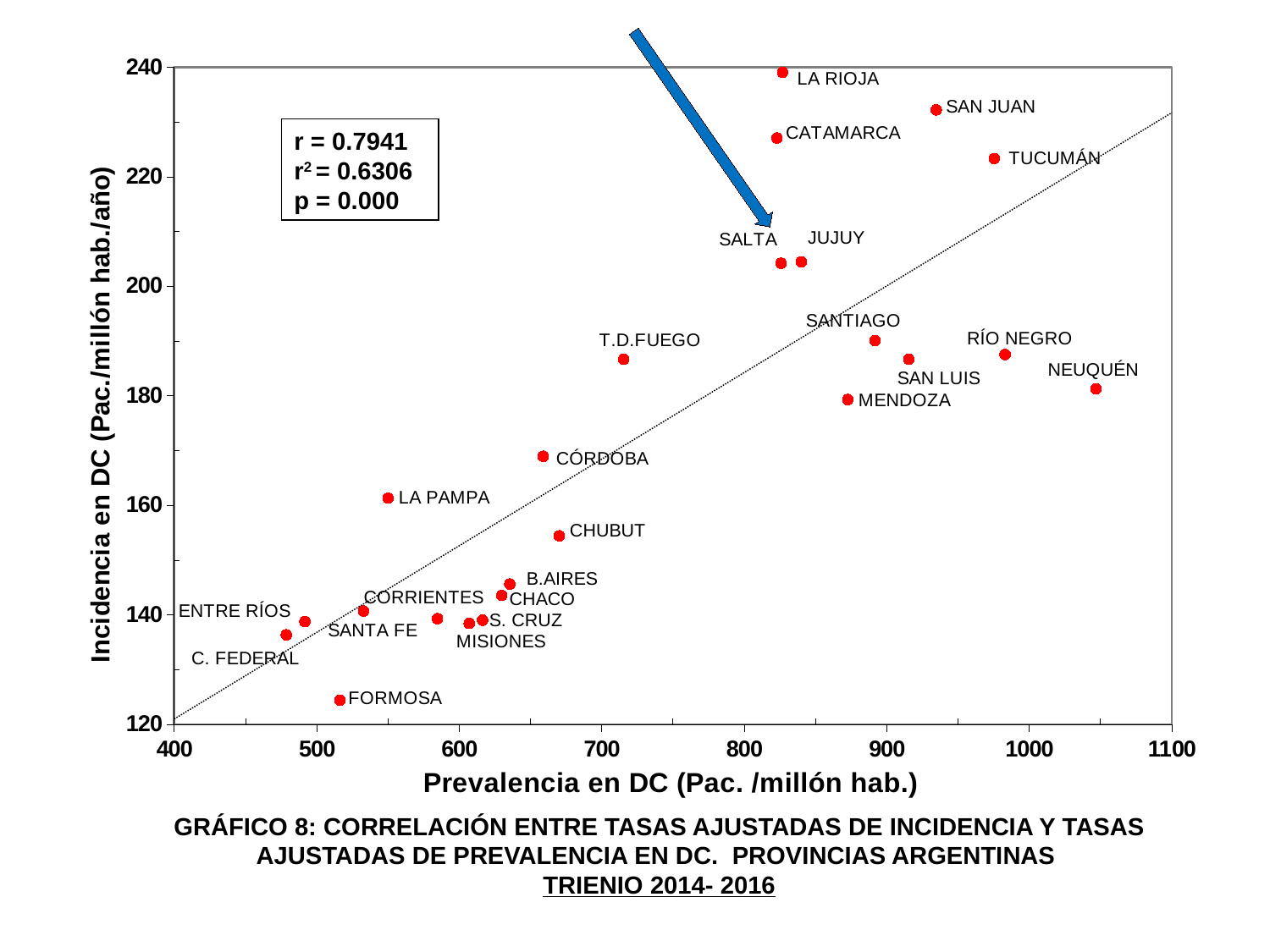
What is the correlation coefficient r shown in the box on the chart? r = 0.7941 Is the incidence value for FORMOSA greater or less than 140? less Is the incidence value for CHUBUT greater or less than 160? less Which province has the highest incidence (Incidencia en DC) on the chart? LA RIOJA How many provinces are plotted on the chart? 24 Which has the higher incidence, SAN JUAN or TUCUMÁN? SAN JUAN Which province has the lowest incidence (Incidencia en DC) on the chart? FORMOSA What kind of chart is shown on the slide? scatter plot Is the prevalence value for NEUQUÉN greater or less than 1000? greater Which province has the highest prevalence (Prevalencia en DC) on the chart? NEUQUÉN